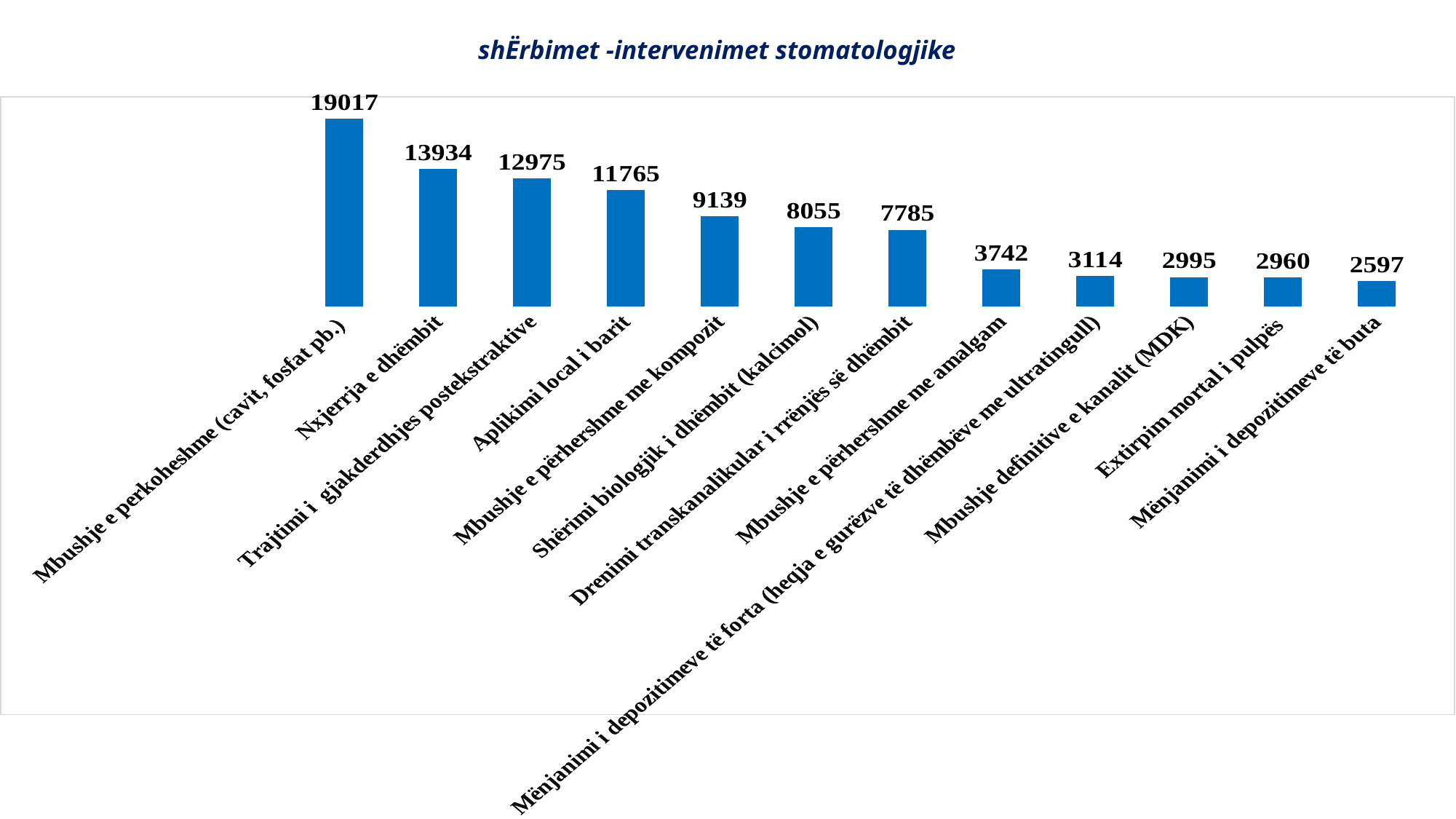
What is the difference between the values for Mbushje e perkoheshme (cavit, fosfat pb.) and Nxjerrja e dhëmbit? 5083 How many categories are shown in the chart? 12 Do the values rise or fall from left to right along the x axis? Fall Which category has the lowest value? Mënjanimi i depozitimeve të buta What is the value for Extirpim mortal i pulpës? 2960 Which category has the highest value? Mbushje e perkoheshme (cavit, fosfat pb.) What is the value for Aplikimi local i barit? 11765 What kind of chart is shown on the slide? Bar chart What is the value for Nxjerrja e dhëmbit? 13934 What is the difference between the values for Shërimi biologjik i dhëmbit (kalcimol) and Drenimi transkanalikular i rrënjës së dhëmbit? 270 Which is larger: the value for Mbushje e përhershme me kompozit or the value for Trajtimi i gjakderdhjes postekstraktive? Trajtimi i gjakderdhjes postekstraktive What is the value for Mbushje e përhershme me amalgam? 3742